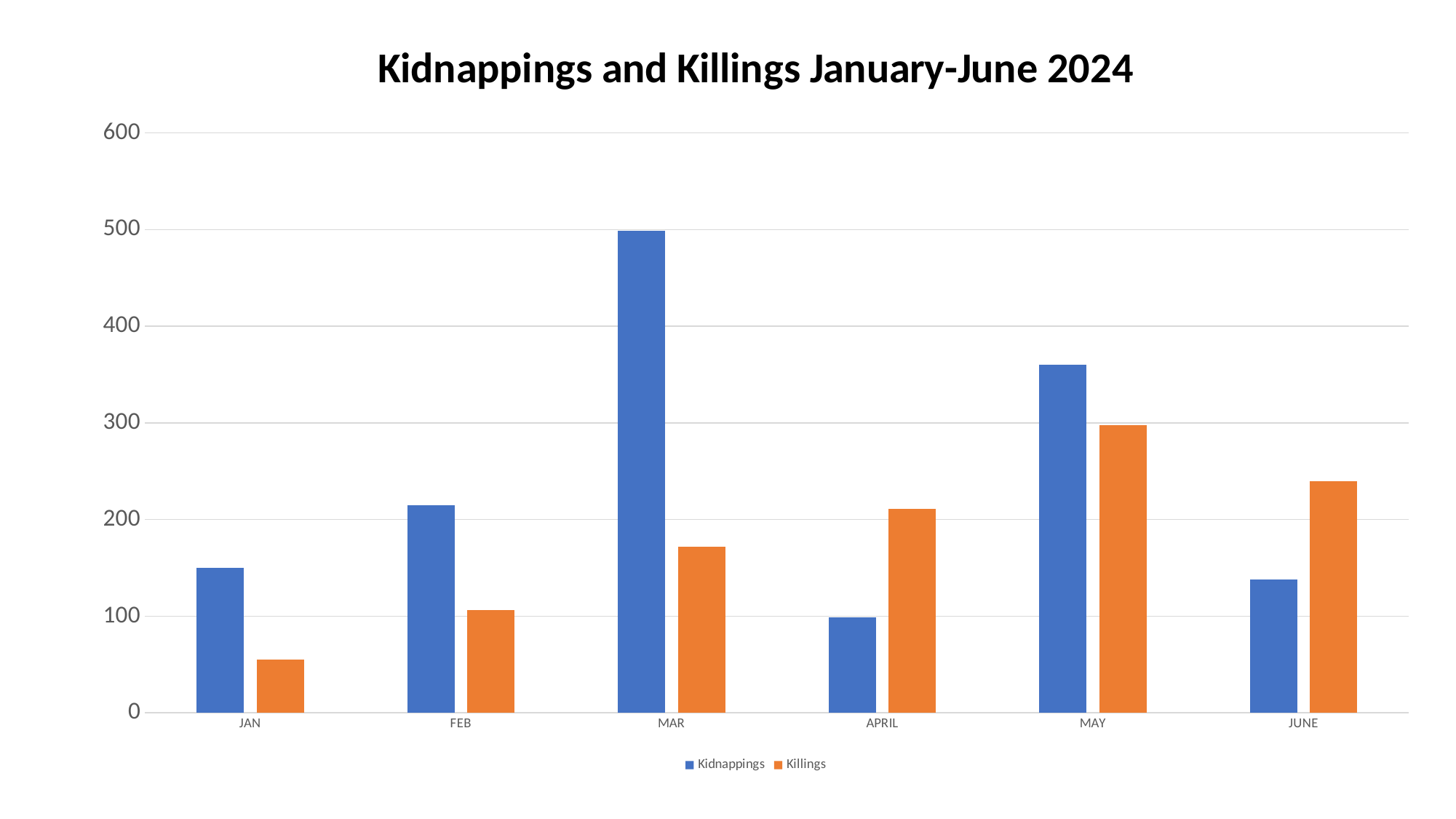
What kind of chart is shown on the slide? bar chart Is the Killings value for JAN greater or less than 100? less In which month is the Kidnappings value lowest? APRIL In which month is the Killings value lowest? JAN In APRIL, which is larger, Kidnappings or Killings? Killings Do the Killings values rise or fall from JAN to MAY? rise In which month is the Killings value highest? MAY Is the Kidnappings value for MAR greater or less than 400? greater How many series does the legend list? 2 In which month is the Kidnappings value highest? MAR How many months are shown on the x axis? 6 Is the Killings value for JUNE greater or less than 200? greater